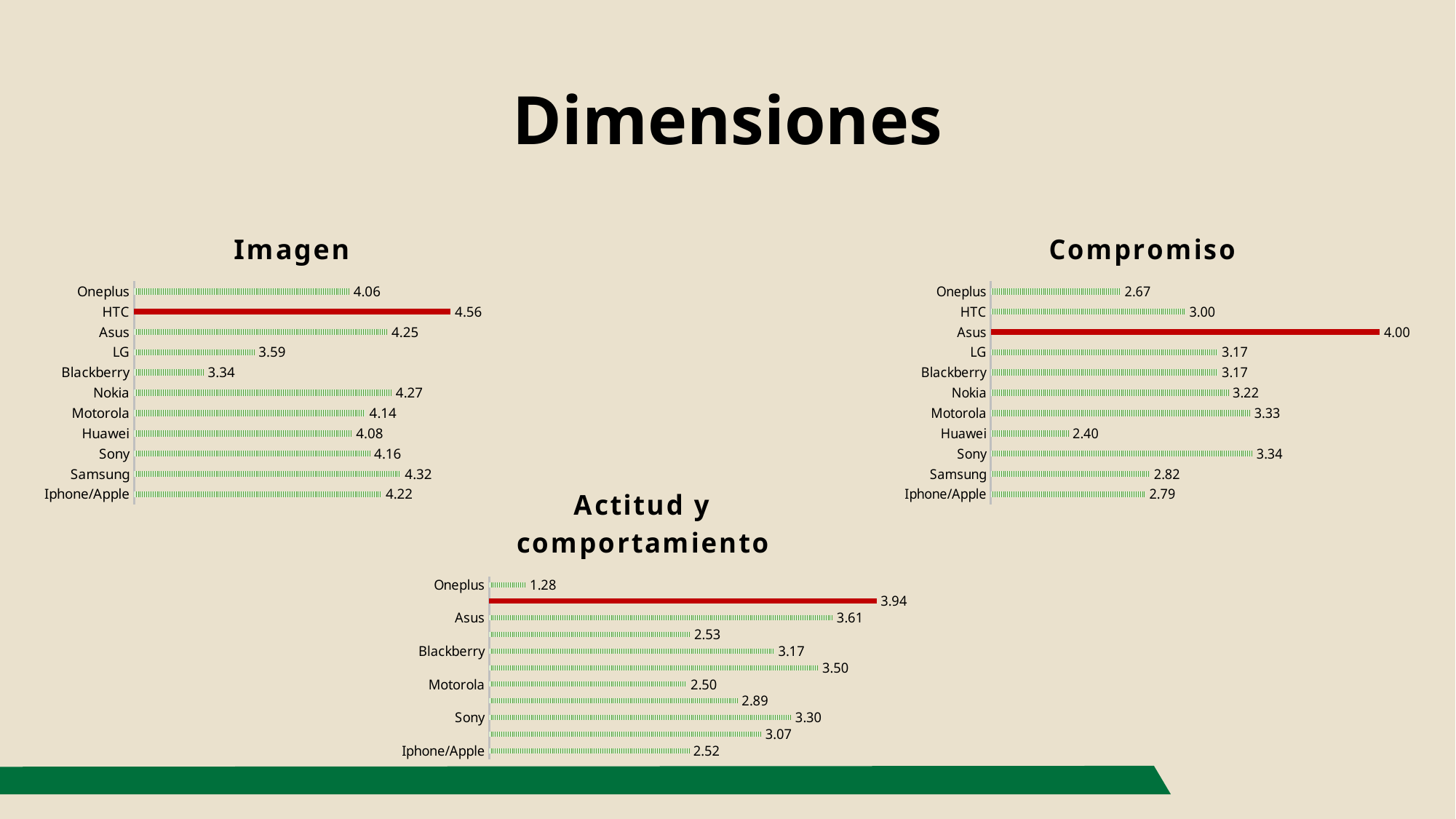
In the Imagen chart, which brand has the lowest value? Blackberry In the Compromiso chart, what is the difference between Asus and Oneplus? 1.33 In the Imagen chart, what is the difference between Samsung and LG? 0.73 In the Actitud y comportamiento chart, what is the value for Oneplus? 1.28 What kind of chart is the Imagen chart? Bar chart In the Compromiso chart, which is larger, the value for Sony or the value for Samsung? Sony In the Compromiso chart, what is the value for Huawei? 2.40 In the Compromiso chart, which brand has the highest value? Asus In the Actitud y comportamiento chart, what is the value for Asus? 3.61 In the Imagen chart, what is the value for HTC? 4.56 How many charts are shown on the slide? 3 In the Imagen chart, how many brands are listed? 11